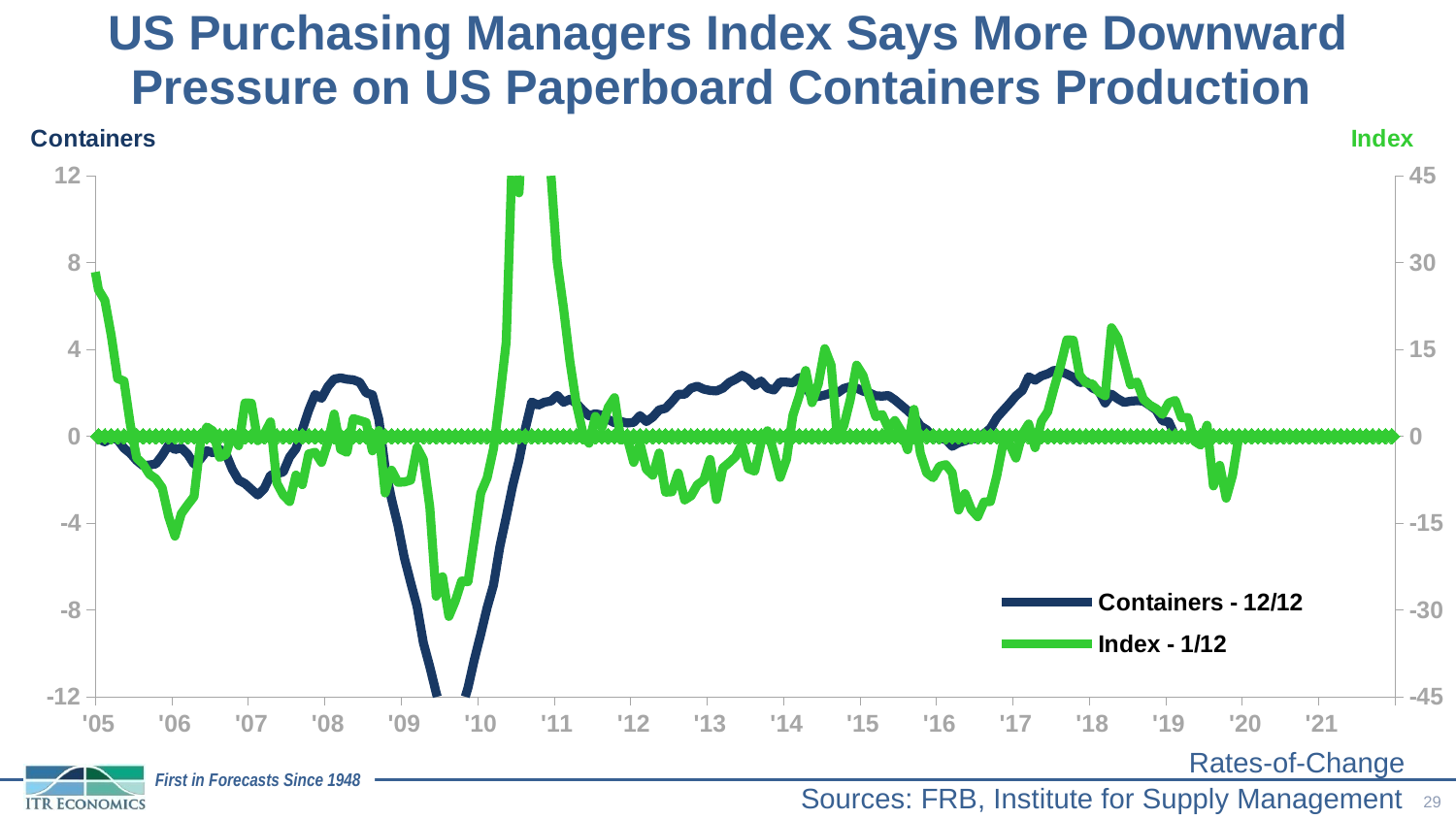
Is the peak of the Index - 1/12 line around '10 to '11 greater or less than 30 on the Index axis? greater Is the Containers - 12/12 value at its '08 peak greater or less than 0? greater What kind of chart is shown on the slide? Line chart Does the Index - 1/12 line rise or fall from the start of '05 to '06? Fall Is the lowest value of the Containers - 12/12 line around '09 greater or less than -8? less Does the Containers - 12/12 line rise or fall from '18 to '19? Fall How many series does the legend list? 2 What is the title of the right-hand vertical axis? Index How many year labels are shown along the x axis? 17 What are the two series named in the legend? Containers - 12/12 and Index - 1/12